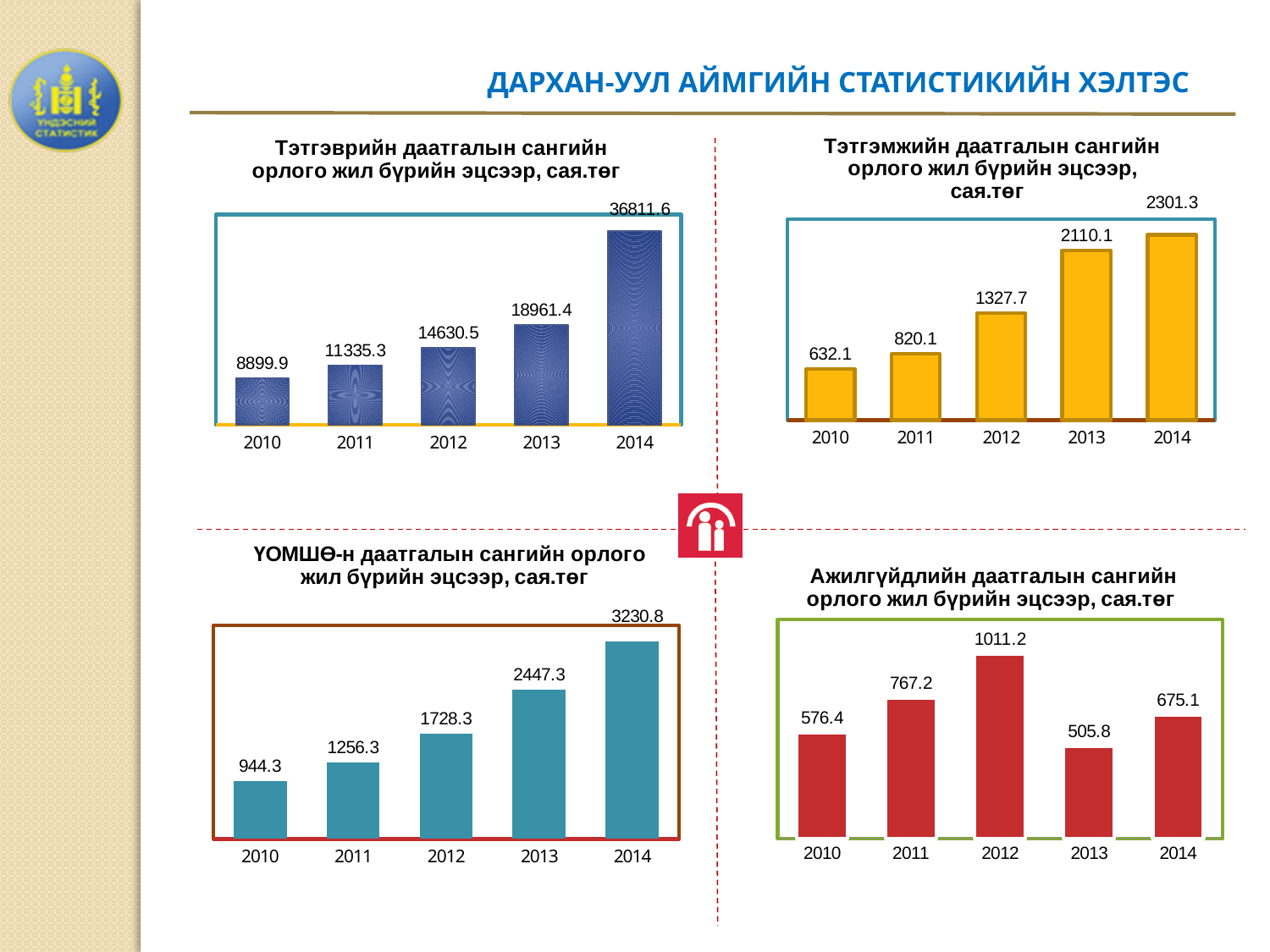
How many years are shown in the top-right chart (Тэтгэмжийн даатгалын сангийн орлого)? 5 In the bottom-right chart (Ажилгүйдлийн даатгалын сангийн орлого), what is the value for 2013? 505.8 In the top-left chart (Тэтгэврийн даатгалын сангийн орлого), what is the value for 2014? 36811.6 In the bottom-right chart (Ажилгүйдлийн даатгалын сангийн орлого), which is larger, the value for 2011 or the value for 2014? 2011 In the top-right chart (Тэтгэмжийн даатгалын сангийн орлого), what is the value for 2012? 1327.7 In the bottom-right chart (Ажилгүйдлийн даатгалын сангийн орлого), which year has the highest value? 2012 In the bottom-left chart (ҮОМШӨ-н даатгалын сангийн орлого), what is the difference between the 2014 and 2010 values? 2286.5 In the top-left chart (Тэтгэврийн даатгалын сангийн орлого), what is the value for 2010? 8899.9 In the top-right chart (Тэтгэмжийн даатгалын сангийн орлого), which year has the lowest value? 2010 In the bottom-left chart (ҮОМШӨ-н даатгалын сангийн орлого), what is the value for 2013? 2447.3 What kind of chart is the bottom-left chart (ҮОМШӨ-н даатгалын сангийн орлого)? bar chart In the top-left chart (Тэтгэврийн даатгалын сангийн орлого), do the values rise or fall from 2010 to 2014? rise